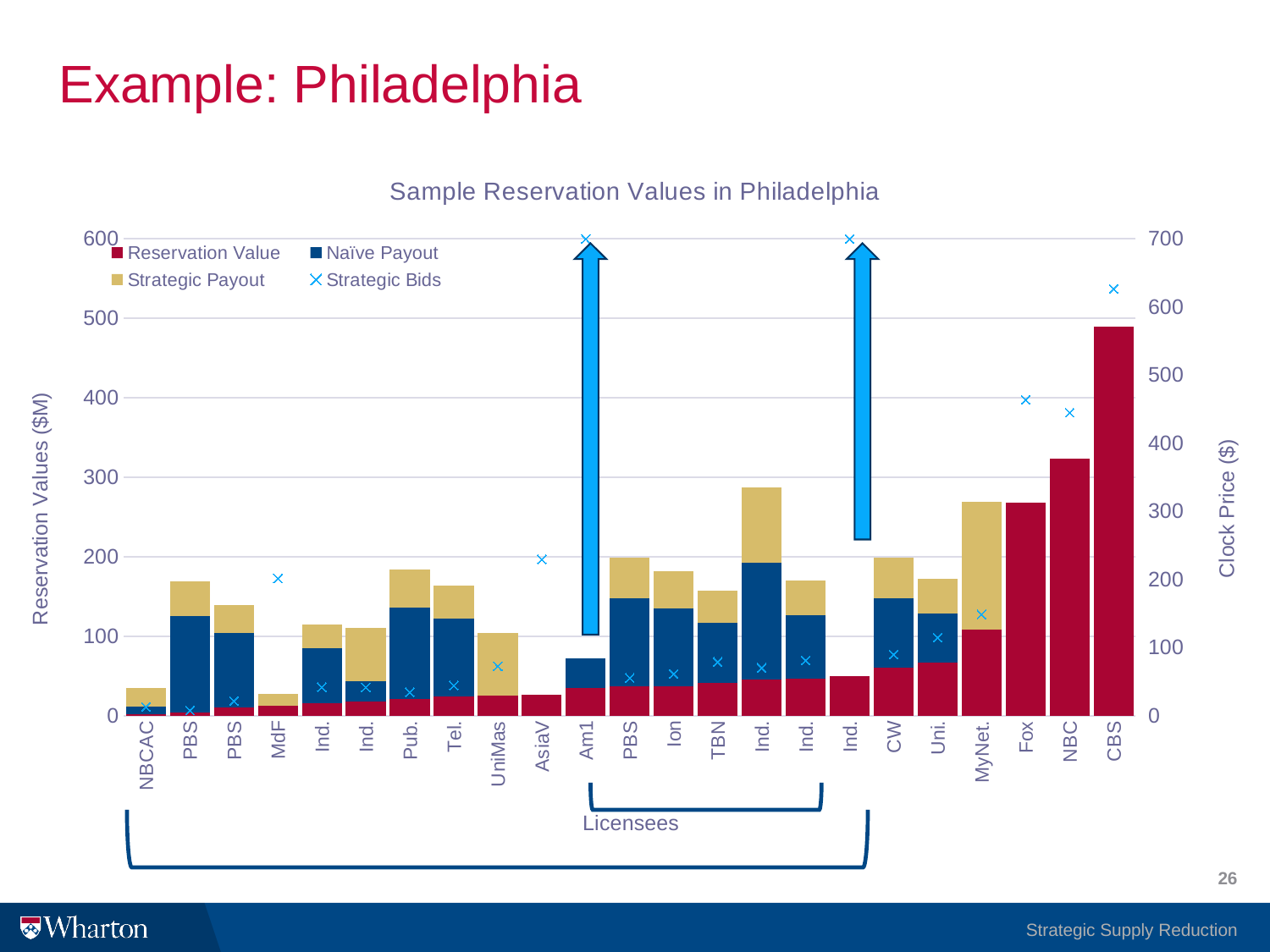
What kind of chart is shown on the slide? Stacked bar chart with x markers What is the title of the chart? Sample Reservation Values in Philadelphia How many categories are shown along the x axis? 23 How many series does the legend list? 4 Which has the taller bar, CBS or NBC? CBS Which category has the tallest bar? CBS Is the total bar height for Am1 greater or less than 100 on the left axis? less What is the label of the right-hand vertical axis? Clock Price ($) Is the total bar height for NBC greater or less than 300 on the left axis? greater Which category has the largest Reservation Value (red segment)? CBS Is the total bar height for CBS greater or less than 400 on the left axis? greater